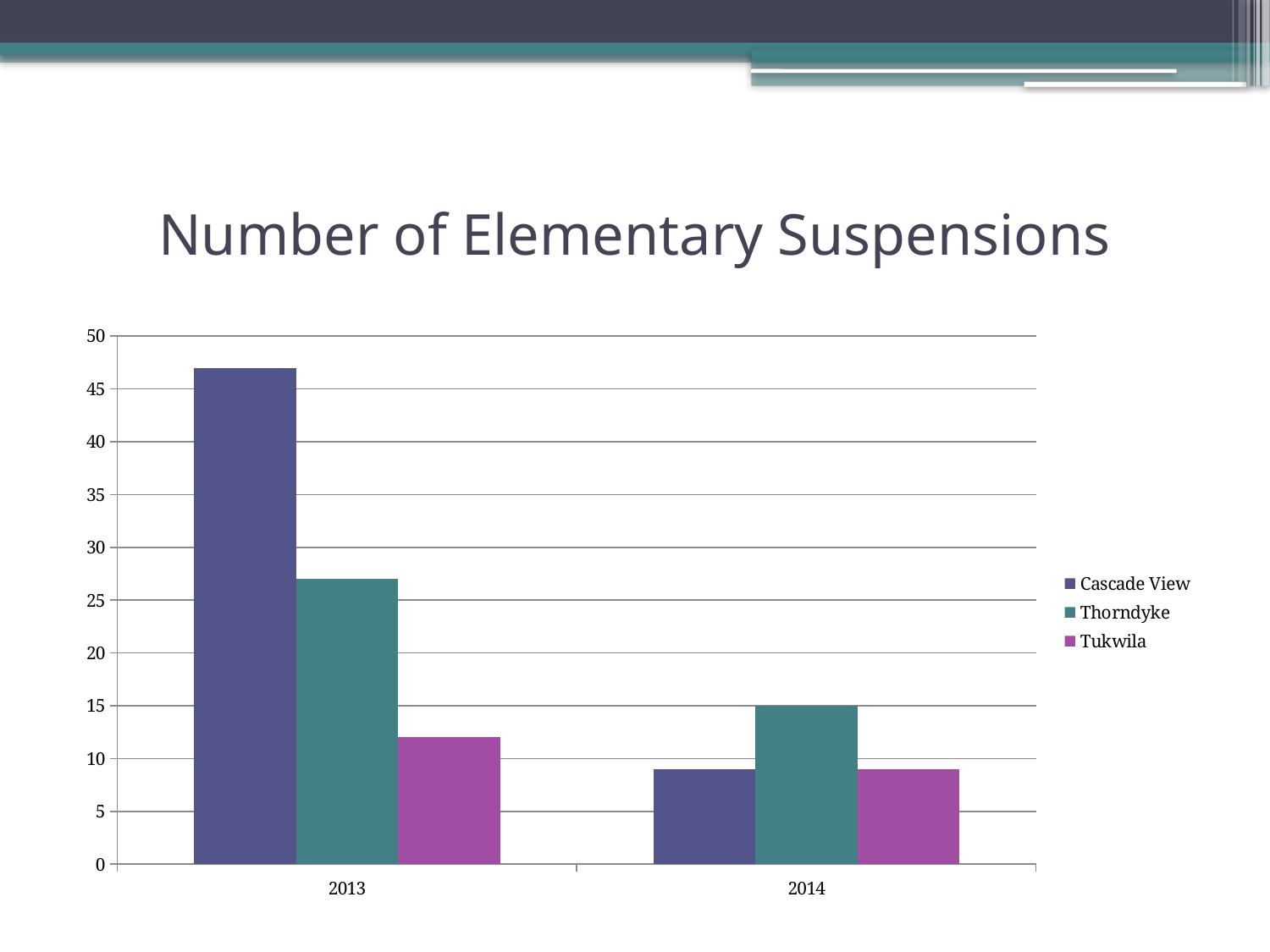
Is the value for Cascade View in 2013 greater or less than 45? greater How many series does the legend list? 3 Which school had the highest number of suspensions in 2014? Thorndyke Which school had the highest number of suspensions in 2013? Cascade View Which school had the lowest number of suspensions in 2013? Tukwila Did the number of suspensions for Thorndyke rise or fall from 2013 to 2014? fall What type of chart is shown on the slide? bar chart Is the value for Cascade View in 2014 greater or less than 10? less Is the value for Thorndyke in 2013 greater or less than 25? greater Which is larger: Cascade View in 2013 or Cascade View in 2014? Cascade View in 2013 What is the title of the chart? Number of Elementary Suspensions How many year categories are shown on the x axis? 2